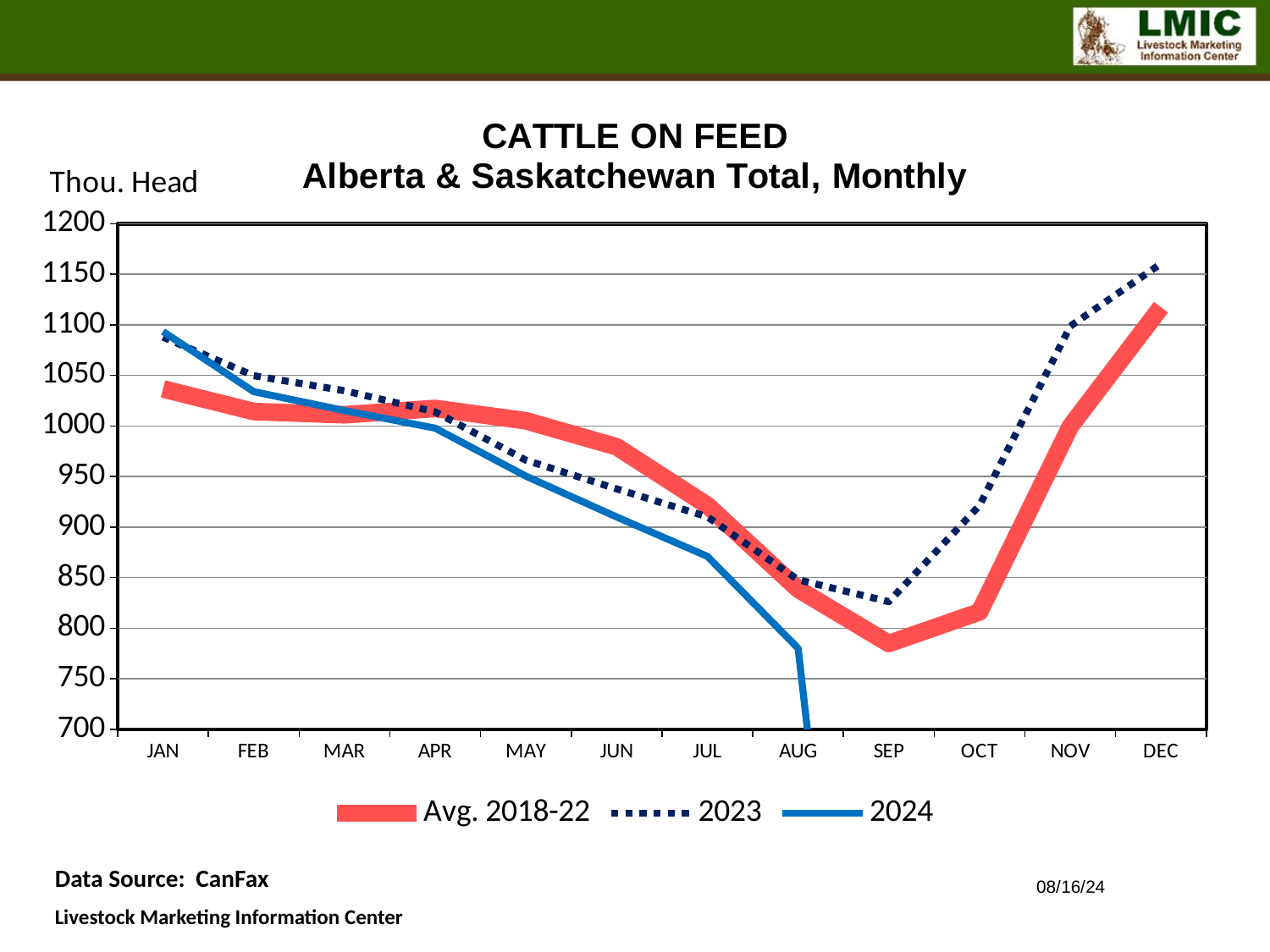
In which month is the 2023 series at its highest? DEC Is the 2023 value for NOV greater or less than 1050? greater What unit label is shown above the y axis? Thou. Head Is the 2023 value for SEP greater or less than 850? less What is the title of the chart? CATTLE ON FEED Alberta & Saskatchewan Total, Monthly How many series does the legend list? 3 In which month is the 2023 series at its lowest? SEP What kind of chart is shown on the slide? line chart How many months are shown along the x axis? 12 In JAN, which series is higher, 2024 or Avg. 2018-22? 2024 Is the 2024 value for JUL greater or less than 900? less In which month is the Avg. 2018-22 series at its lowest? SEP